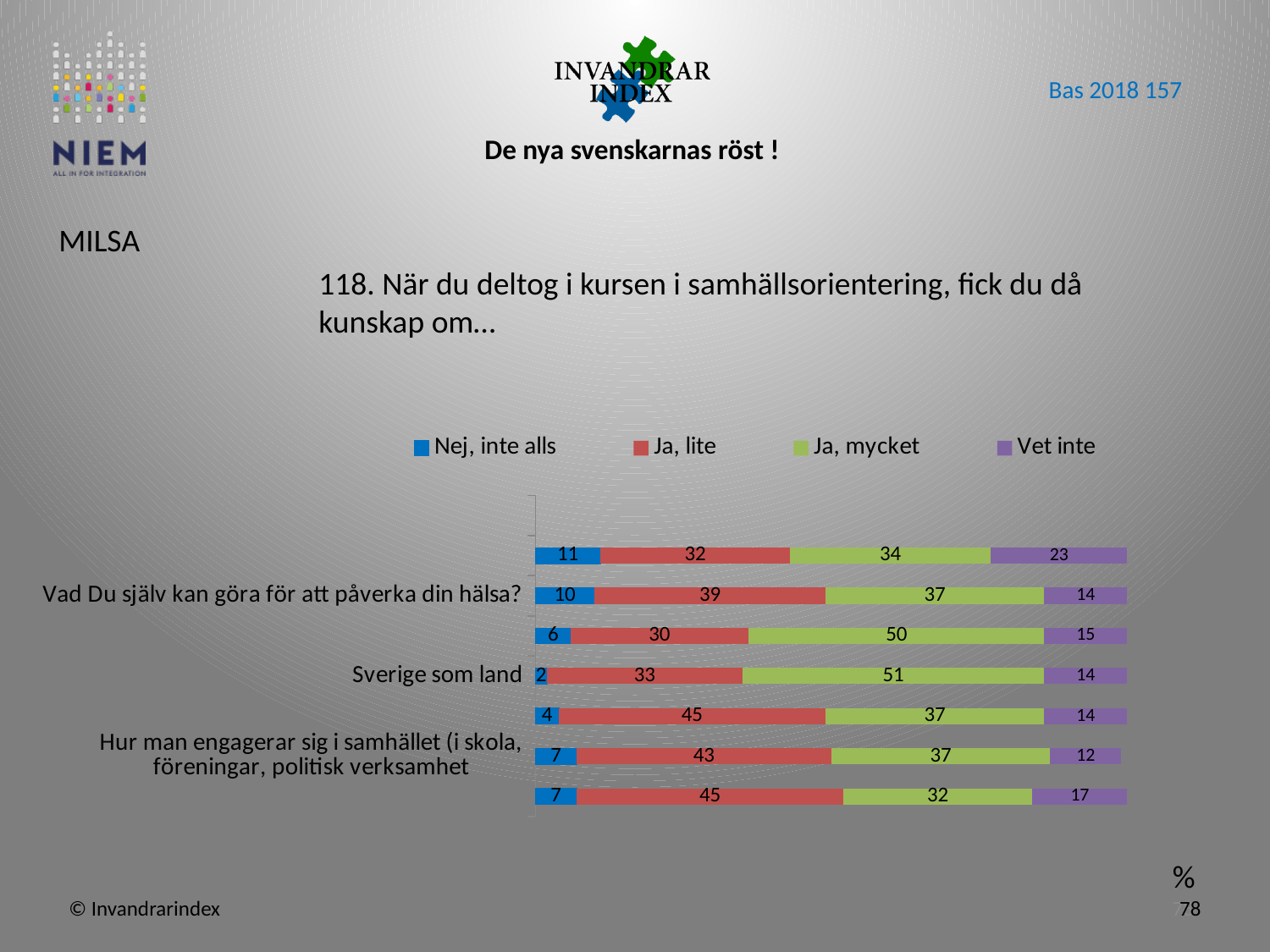
What is the value for "Ja, mycket" for "Hur man engagerar sig i samhället (i skola, föreningar, politisk verksamhet"? 37 Which has the larger "Ja, mycket" value: "Sverige som land" or "Vad Du själv kan göra för att påverka din hälsa?"? Sverige som land What is the value for "Ja, lite" for "Hur man engagerar sig i samhället (i skola, föreningar, politisk verksamhet"? 43 What is the value for "Ja, mycket" for "Sverige som land"? 51 Which series has the largest value in the "Sverige som land" bar? Ja, mycket What is the value for "Vet inte" for "Vad Du själv kan göra för att påverka din hälsa?"? 14 How many stacked bars are plotted in the chart? 7 What kind of chart is shown on the slide? Stacked bar chart How many series does the legend list? 4 What is the value for "Nej, inte alls" for "Sverige som land"? 2 What is the total of the stacked bar for "Sverige som land"? 100 What is the difference in the "Ja, lite" value between "Hur man engagerar sig i samhället (i skola, föreningar, politisk verksamhet" and "Sverige som land"? 10